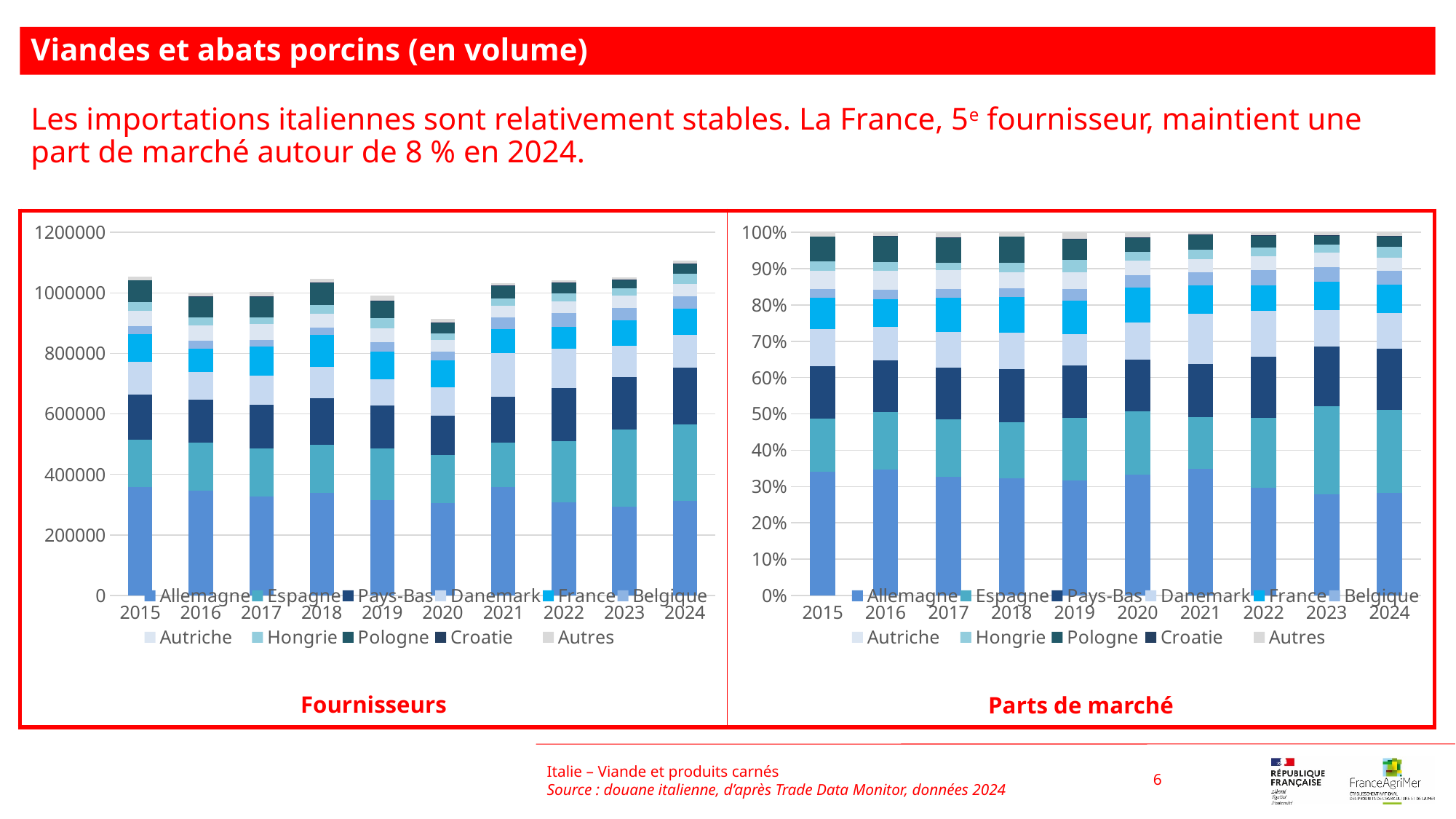
What is the title of the chart on the right? Parts de marché In the 'Fournisseurs' chart, which year has the highest total bar? 2024 In the 'Fournisseurs' chart, is the total bar for 2024 greater or less than 1000000? greater How many series does the legend of the 'Fournisseurs' chart list? 11 In the 'Parts de marché' chart, which series is shown at the bottom of each stacked bar? Allemagne In the 'Fournisseurs' chart, is the total bar for 2020 greater or less than 1000000? less What kind of chart is the 'Fournisseurs' chart on the left? stacked bar chart In the 'Fournisseurs' chart, which total bar is larger, 2020 or 2024? 2024 In the 'Fournisseurs' chart, is the Allemagne segment for 2015 greater or less than 400000? less How many years are shown on the x axis of the 'Parts de marché' chart? 10 In the 'Fournisseurs' chart, which year has the lowest total bar? 2020